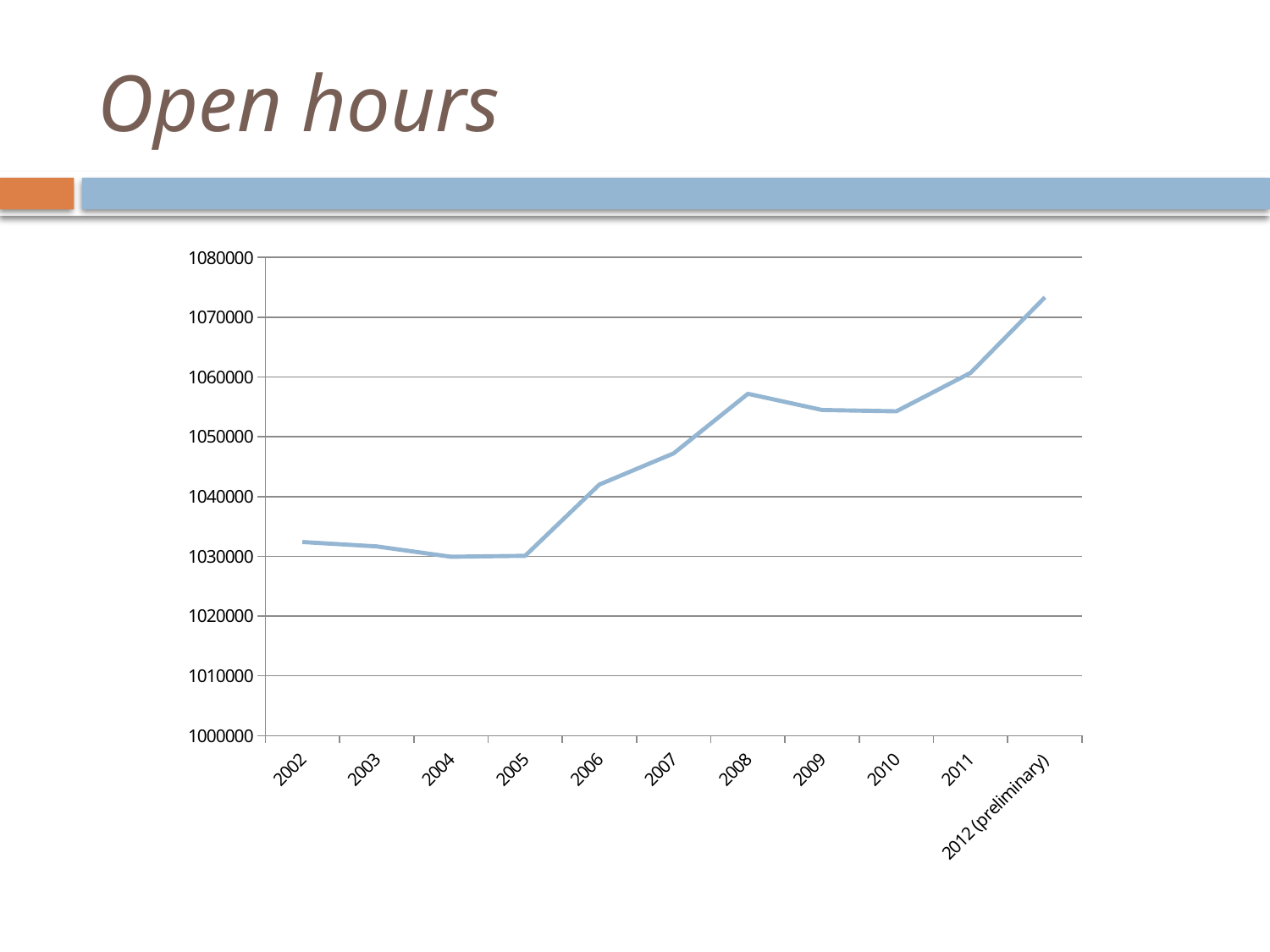
What is the title of the slide? Open hours Is the value for 2012 (preliminary) greater or less than 1070000? greater What kind of chart is shown on the slide? line chart Is the value for 2009 greater or less than 1060000? less Is the value for 2007 greater or less than 1050000? less How many years (data points) are plotted along the x axis? 11 Overall, do the values rise or fall from 2002 to 2012 (preliminary)? rise Which year has the highest value? 2012 (preliminary) Which is larger, the value for 2007 or the value for 2008? 2008